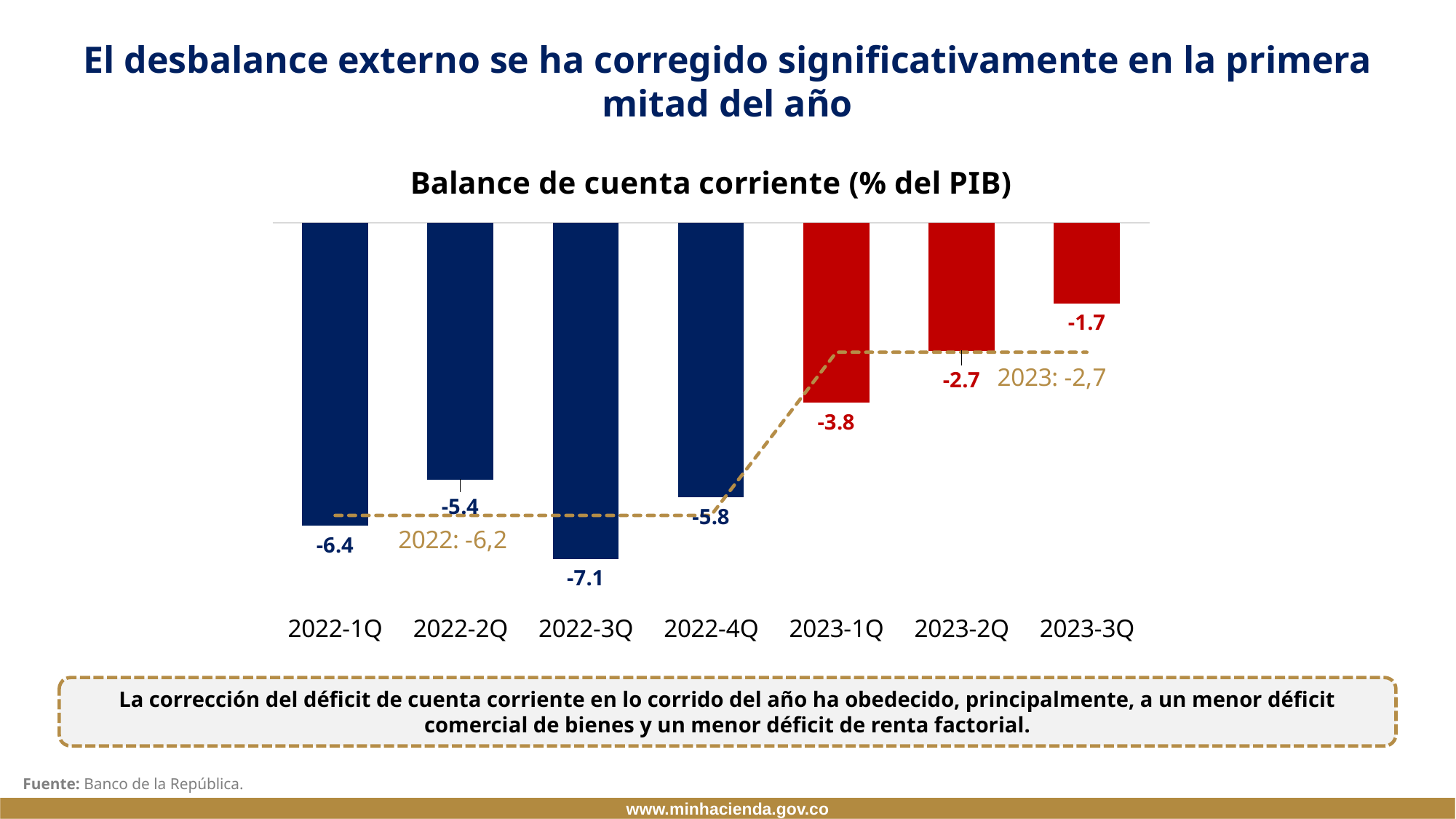
Do the values rise or fall from 2022-3Q to 2023-3Q? Rise What is the title of the chart? Balance de cuenta corriente (% del PIB) What is the difference between the values for 2022-1Q and 2023-1Q? 2.6 How many quarters are shown on the chart? 7 Which quarter has the lowest (most negative) current account balance? 2022-3Q What is the value shown for 2023-1Q? -3.8 Which is larger, the value for 2022-2Q or the value for 2022-4Q? 2022-2Q What kind of chart is shown on the slide? Bar chart with a dashed line (combination bar and line chart) What is the value shown for 2023-3Q? -1.7 What is the current account balance value for 2022-3Q? -7.1 What annual average is annotated for 2023 on the chart? -2,7 Which quarter has the highest (least negative) current account balance? 2023-3Q